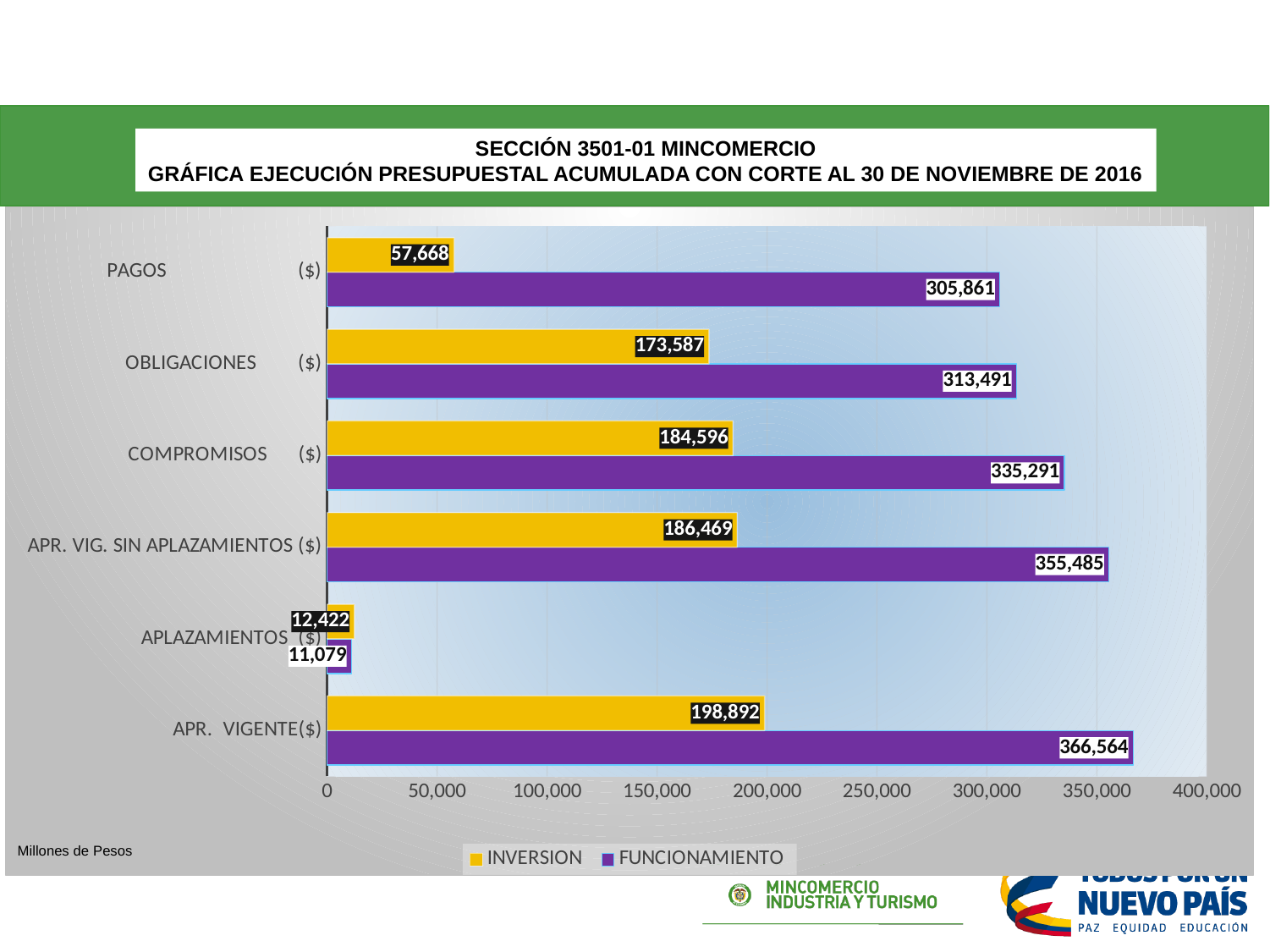
Which category has the highest FUNCIONAMIENTO value? APR. VIGENTE Which is larger for APLAZAMIENTOS, the INVERSION value or the FUNCIONAMIENTO value? INVERSION Is the FUNCIONAMIENTO value for PAGOS greater or less than 300,000? greater What kind of chart is shown on the slide? bar chart What is the difference between the FUNCIONAMIENTO and INVERSION values for OBLIGACIONES? 139,904 What is the FUNCIONAMIENTO value for COMPROMISOS? 335,291 What is the INVERSION value for PAGOS? 57,668 What is the INVERSION value for APLAZAMIENTOS? 12,422 How many categories are shown on the chart? 6 How many series does the legend list? 2 Which category has the lowest INVERSION value? APLAZAMIENTOS What is the FUNCIONAMIENTO value for APR. VIGENTE? 366,564